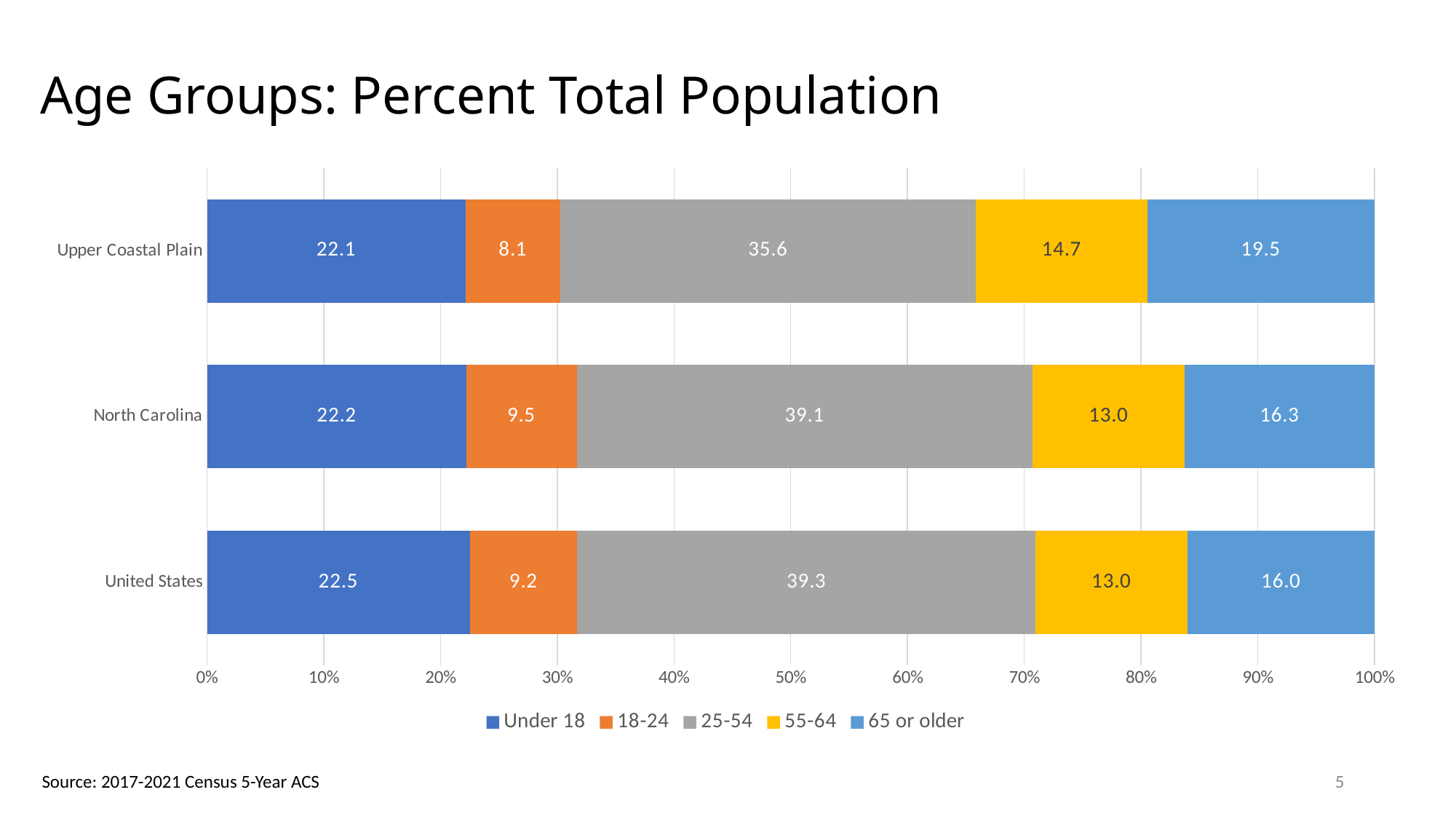
What kind of chart is shown on the slide? Stacked bar chart What is the difference between the 25-54 values for the United States and the Upper Coastal Plain? 3.7 Which region has the lowest value for the 25-54 age group? Upper Coastal Plain What is the value for the 65 or older age group in North Carolina? 16.3 What is the value for the 25-54 age group in the Upper Coastal Plain? 35.6 What is the value for the 18-24 age group in the United States? 9.2 What is the title of the chart? Age Groups: Percent Total Population Which age group is shown in gray? 25-54 How many regions are shown on the chart? 3 Which is larger: the 18-24 value for North Carolina or for the Upper Coastal Plain? North Carolina Which region has the highest value for the 65 or older age group? Upper Coastal Plain How many series does the legend list? 5